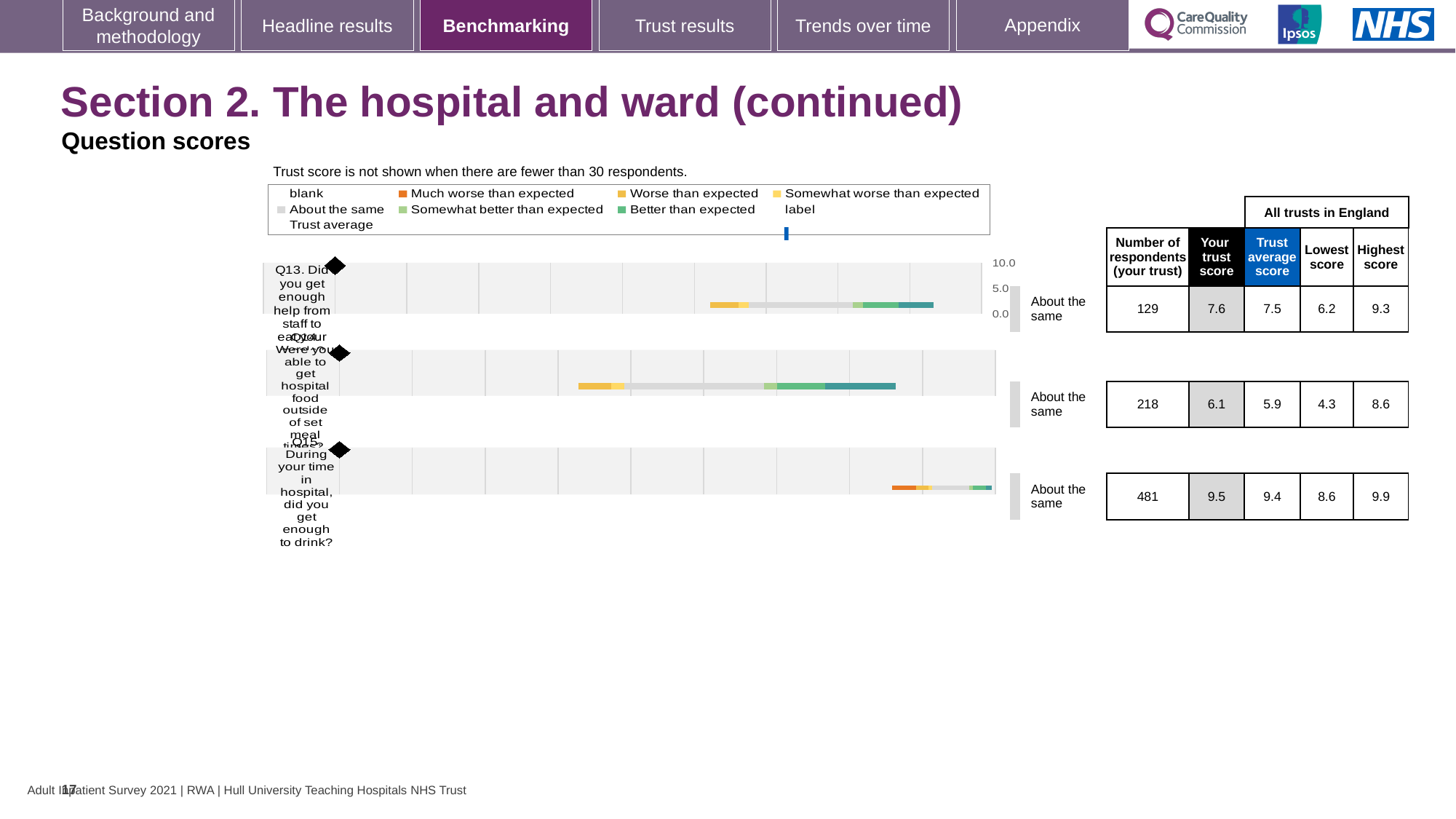
What benchmark category is shown for Q13? About the same Which question has the highest 'Your trust score'? Q15 What kind of chart is used to show the question scores on this slide? bar chart For Q14, which is larger: 'Your trust score' or the trust average score? Your trust score What is the trust average score for Q15 (did you get enough to drink)? 9.4 What is the 'Your trust score' for Q13 (Did you get enough help from staff to eat your meals)? 7.6 How many questions are plotted in the question scores chart? 3 For Q15, what is the difference between the highest score and the lowest score across all trusts in England? 1.3 How many respondents from the trust answered Q14 (Were you able to get hospital food outside of set meal times)? 218 What is the highest score across all trusts in England for Q14? 8.6 For Q13, what is the difference between 'Your trust score' and the trust average score? 0.1 Which question has the lowest 'Your trust score'? Q14